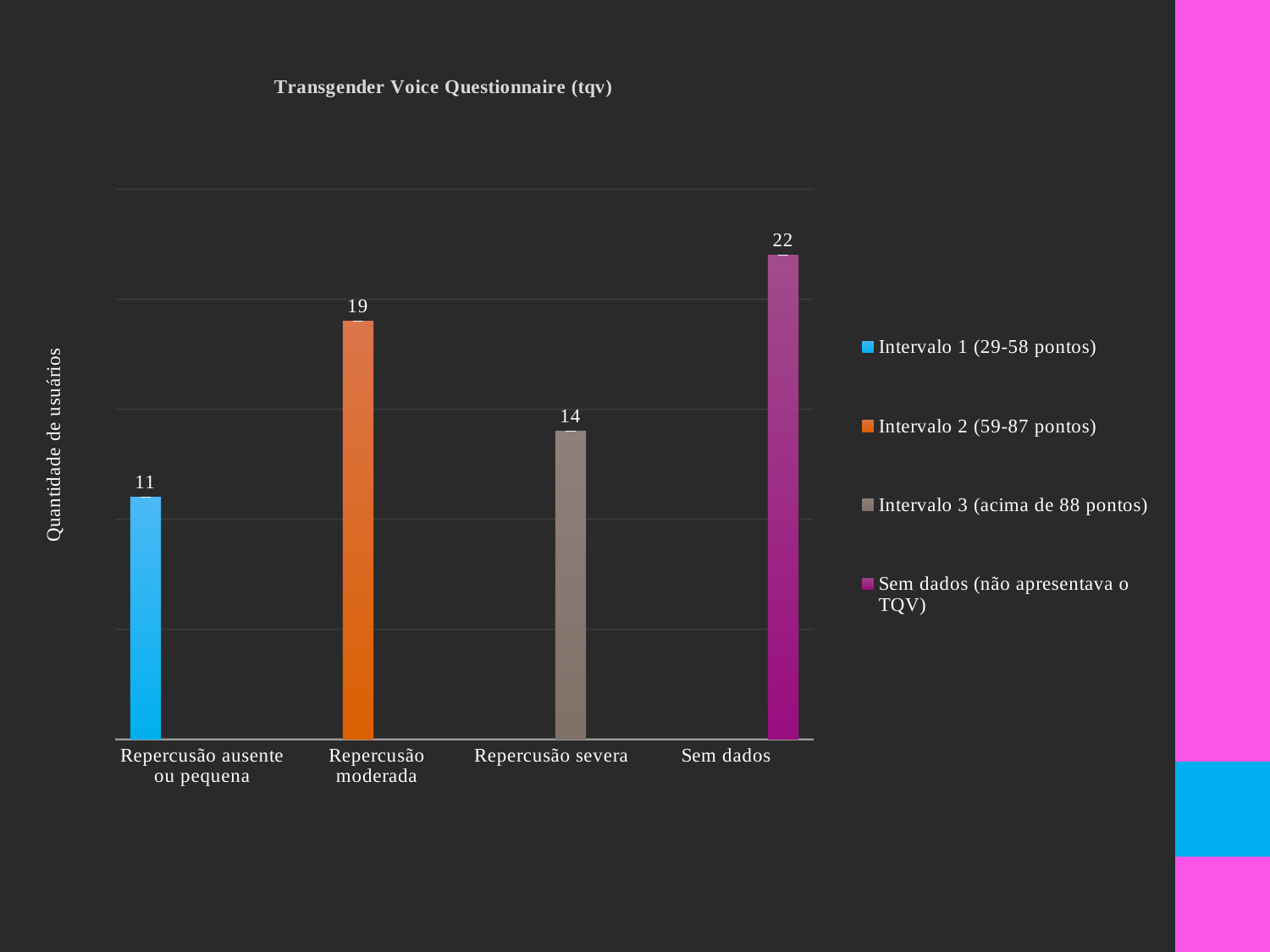
What is the value for "Repercusão severa"? 14 What is the difference between the values for "Sem dados" and "Repercusão ausente ou pequena"? 11 Which category has the lowest value? Repercusão ausente ou pequena Which category has the highest value? Sem dados Which is larger, the value for "Repercusão moderada" or the value for "Repercusão severa"? Repercusão moderada How many entries does the legend list? 4 How many categories are shown on the x axis? 4 What is the value for "Repercusão ausente ou pequena"? 11 What is the value for "Repercusão moderada"? 19 What kind of chart is shown on the slide? Bar chart What is the difference between the values for "Repercusão moderada" and "Repercusão severa"? 5 What is the value for "Sem dados"? 22